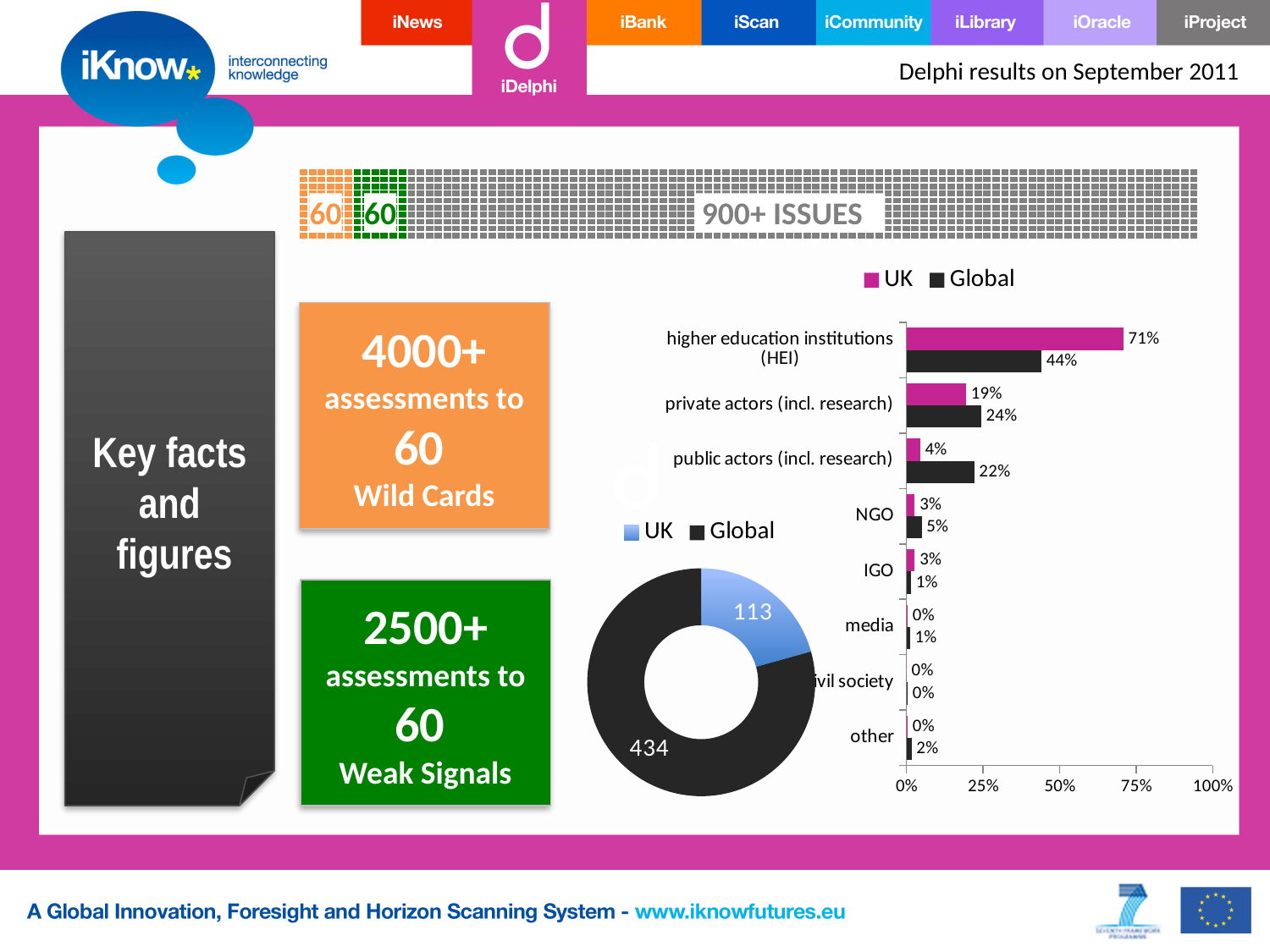
What kind of chart is the chart comparing UK and Global by institution type? bar chart In the bar chart, how many series does the legend list? 2 In the doughnut chart, what is the value for UK? 113 In the bar chart, how many categories are shown on the vertical axis? 8 In the bar chart, what is the Global value for private actors (incl. research)? 24% In the doughnut chart, what is the total of the UK and Global values? 547 In the bar chart, what is the UK value for higher education institutions (HEI)? 71% In the bar chart, what is the Global value for public actors (incl. research)? 22% In the bar chart, what is the difference between the UK and Global values for higher education institutions (HEI)? 27% In the doughnut chart, what is the value for Global? 434 In the bar chart, which is larger for private actors (incl. research), the UK value or the Global value? Global In the bar chart, which category has the highest UK value? higher education institutions (HEI)